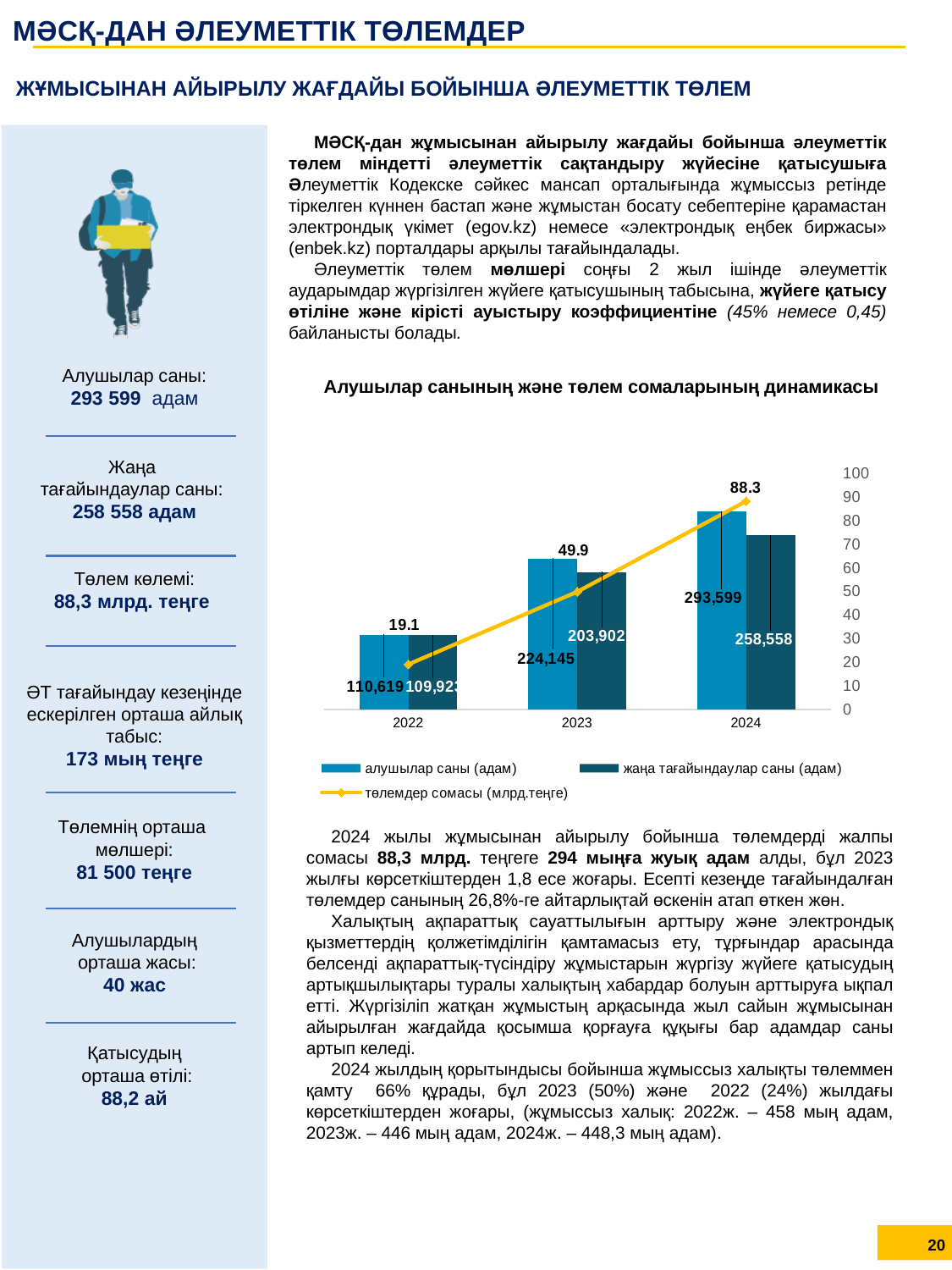
How many years are shown on the x axis of the chart? 3 What is the difference between "төлемдер сомасы (млрд.теңге)" in 2024 and in 2023? 38.4 Which year has the highest value of "төлемдер сомасы (млрд.теңге)"? 2024 Which is larger in 2023: "алушылар саны (адам)" or "жаңа тағайындаулар саны (адам)"? алушылар саны (адам) What is the value of "төлемдер сомасы (млрд.теңге)" for 2024? 88.3 What is the value of "алушылар саны (адам)" for 2023? 224,145 Which year has the lowest value of "алушылар саны (адам)"? 2022 What is the value of "жаңа тағайындаулар саны (адам)" for 2024? 258,558 How many series does the legend of the chart list? 3 Does "төлемдер сомасы (млрд.теңге)" rise or fall from 2022 to 2024? Rise What kind of chart is shown under the title "Алушылар санының және төлем сомаларының динамикасы"? Combined bar and line chart What is the value of "төлемдер сомасы (млрд.теңге)" for 2022? 19.1